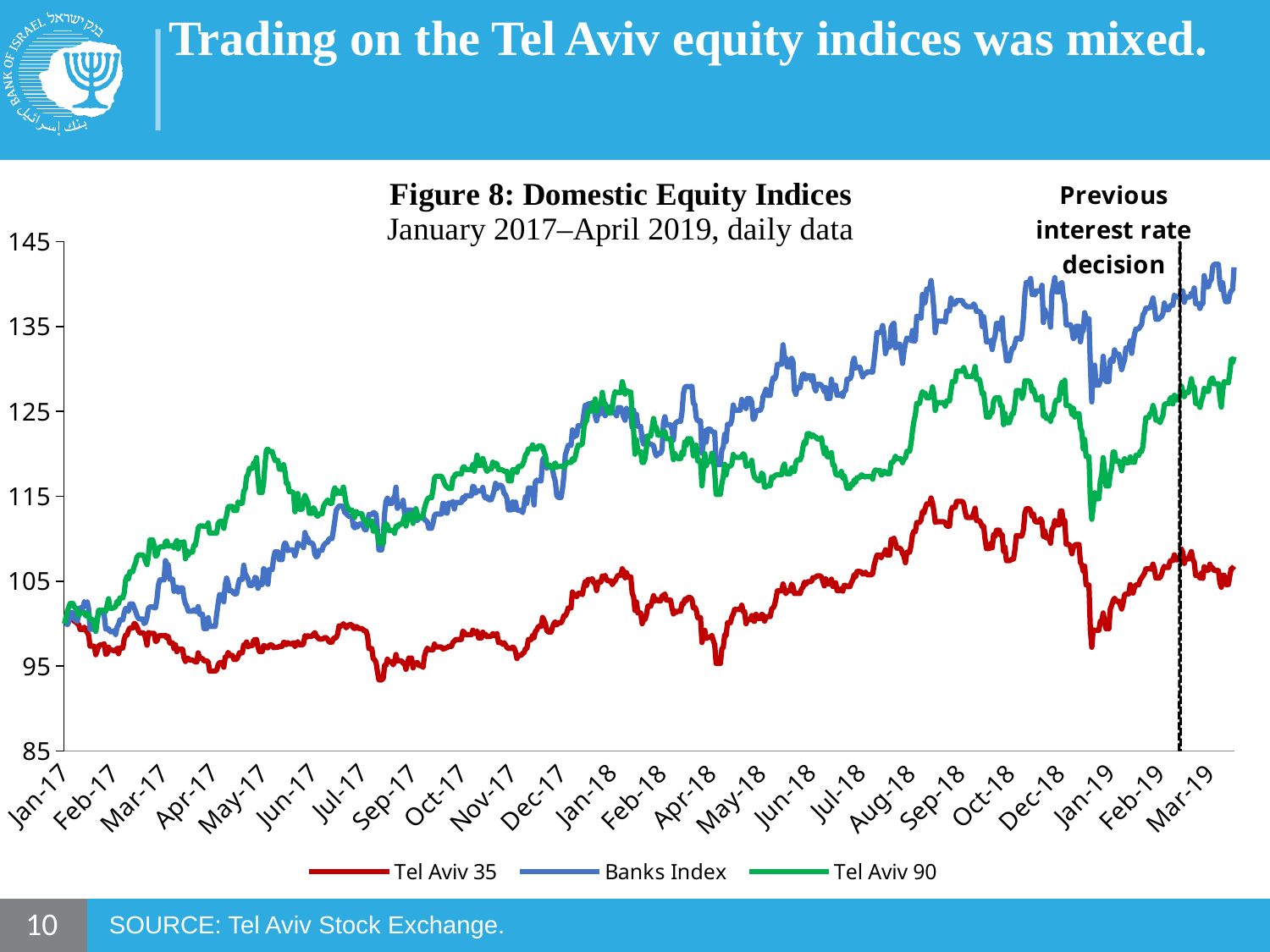
Is the lowest value of Tel Aviv 35 around Jul-17 greater or less than 95? less Which colour is used for the Banks Index line? blue Which series has the lowest value at the right end of the chart (Mar-19)? Tel Aviv 35 Around May-17, which is higher: Tel Aviv 90 or the Banks Index? Tel Aviv 90 Is the value of Tel Aviv 35 at the end of the chart (Mar-19) greater or less than 100? greater Does the Banks Index generally rise or fall from Jan-17 to Mar-19? rise What kind of chart is Figure 8? line chart Is the value of the Banks Index at the end of the chart (Mar-19) greater or less than 135? greater How many series does the legend of Figure 8 list? 3 Which series has the highest value at the right end of the chart (Mar-19)? Banks Index What is the title of the chart on the slide? Figure 8: Domestic Equity Indices